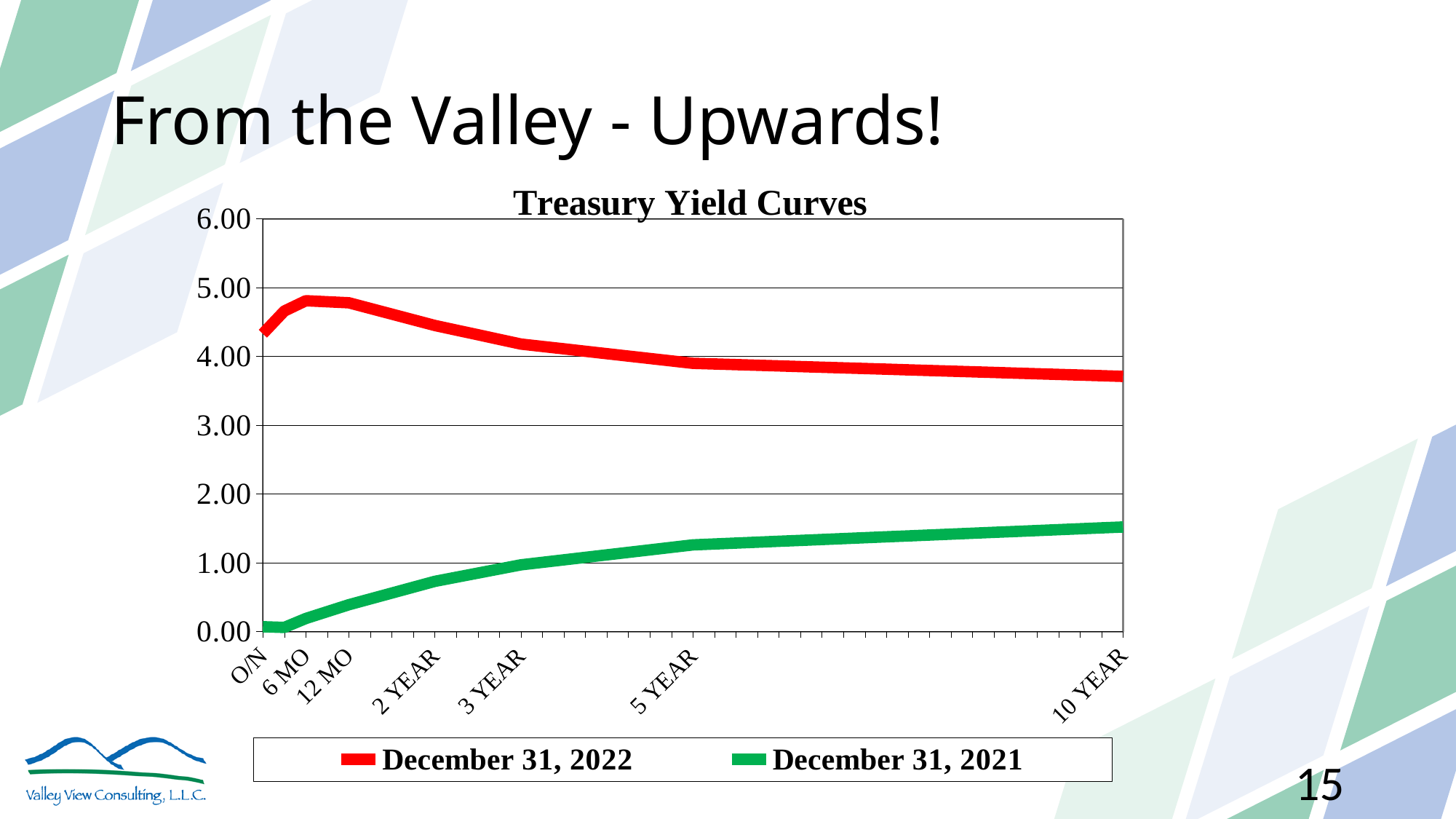
Does the December 31, 2022 line rise or fall from 6 MO to 10 YEAR? Fall How many series does the legend list? 2 At which maturity does the December 31, 2022 line reach its highest value? 6 MO Which colour represents the December 31, 2021 series? Green At 5 YEAR, which series has the higher value, December 31, 2022 or December 31, 2021? December 31, 2022 Is the December 31, 2021 value at 10 YEAR greater or less than 1.00? greater What is the title of the chart? Treasury Yield Curves How many maturity labels are shown on the x axis? 7 Is the December 31, 2022 value at 10 YEAR greater or less than 4.00? less Does the December 31, 2021 line rise or fall from O/N to 10 YEAR? Rise What kind of chart is shown on the slide? Line chart